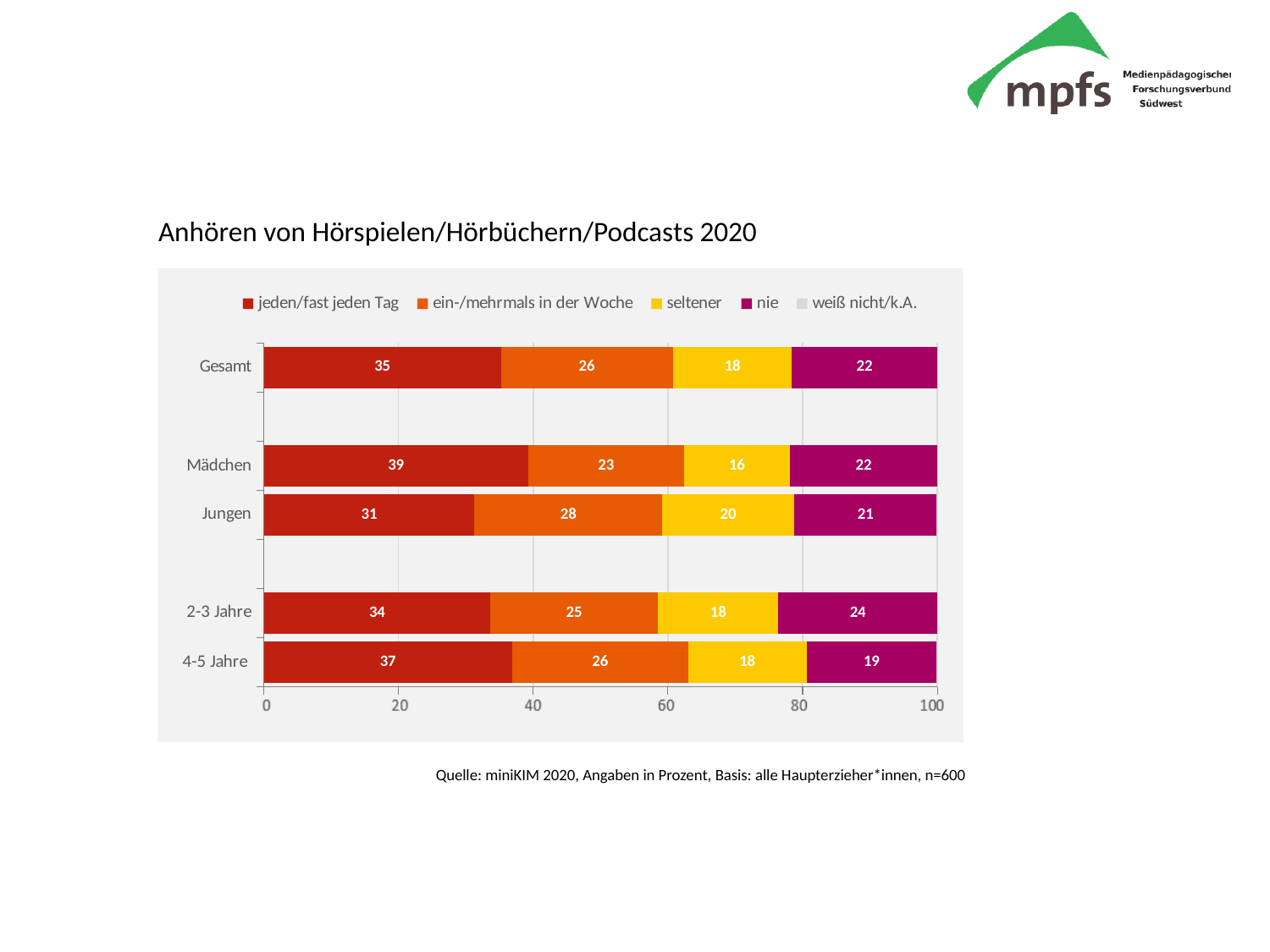
What is the difference between the "jeden/fast jeden Tag" values for Mädchen and Jungen? 8 How many categories are shown on the y axis? 5 What is the value for "nie" for 2-3 Jahre? 24 Which category has the lowest value for "nie"? 4-5 Jahre What is the total of the stacked bar for 4-5 Jahre? 100 Which category has the highest value for "jeden/fast jeden Tag"? Mädchen What is the value for "jeden/fast jeden Tag" for Gesamt? 35 What kind of chart is shown? stacked bar chart How many series does the legend list? 5 What is the title of the chart? Anhören von Hörspielen/Hörbüchern/Podcasts 2020 What is the value for "ein-/mehrmals in der Woche" for Jungen? 28 Which is larger: the "seltener" value for Jungen or for Mädchen? Jungen